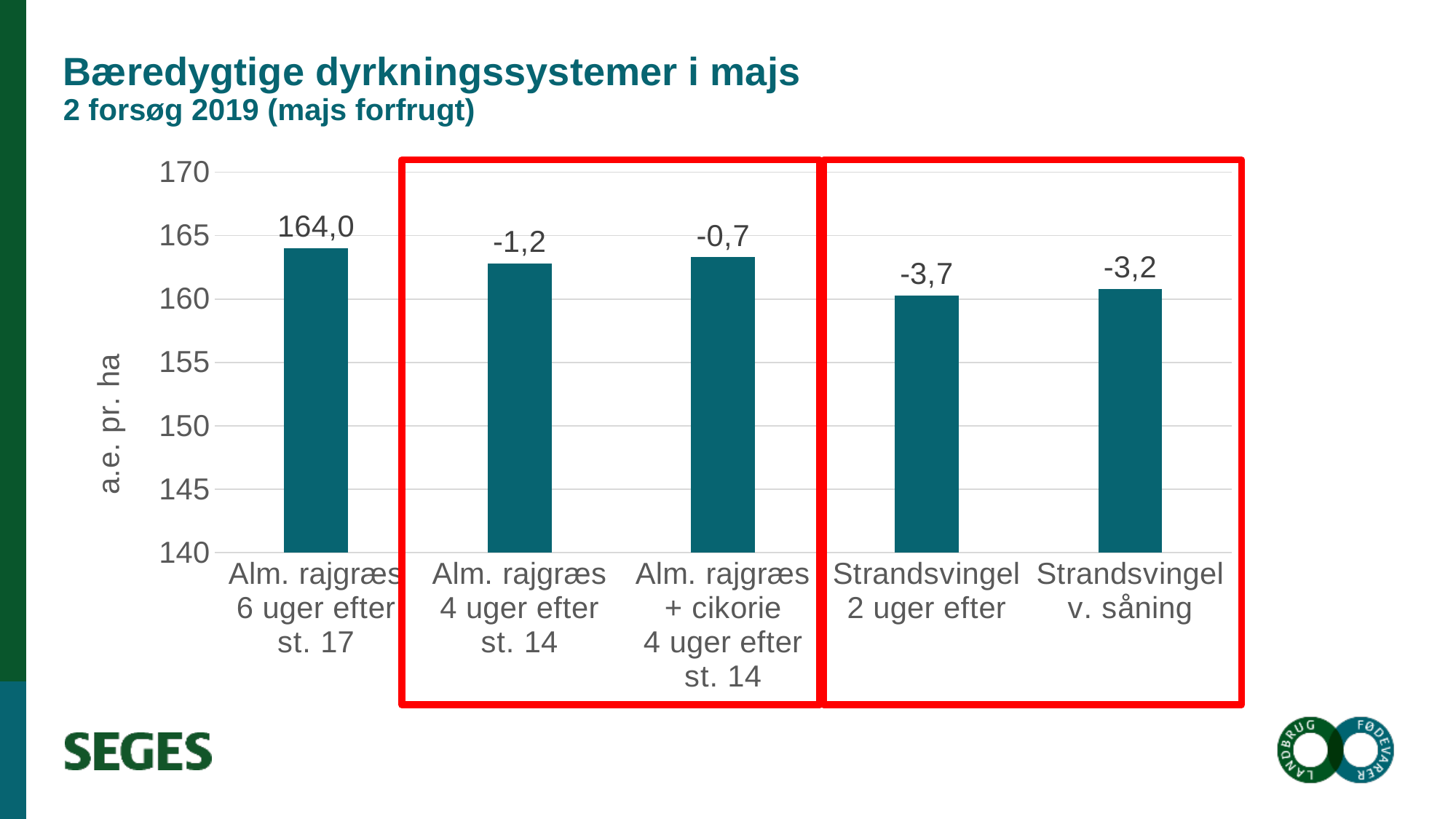
Which category has the shortest bar? Strandsvingel 2 uger efter What data label is shown above the bar for 'Strandsvingel v. såning'? -3,2 What value is printed above the bar for 'Alm. rajgræs 6 uger efter st. 17'? 164,0 Which category has the tallest bar? Alm. rajgræs 6 uger efter st. 17 What data label is shown above the bar for 'Alm. rajgræs + cikorie 4 uger efter st. 14'? -0,7 Is the bar for 'Alm. rajgræs 4 uger efter st. 14' greater or less than 160? greater How many bars (categories) are plotted in the chart? 5 Is the bar for 'Strandsvingel 2 uger efter' greater or less than 165? less What is the label on the vertical axis of the chart? a.e. pr. ha What data label is shown above the bar for 'Alm. rajgræs 4 uger efter st. 14'? -1,2 What data label is shown above the bar for 'Strandsvingel 2 uger efter'? -3,7 What type of chart is shown on the slide? bar chart